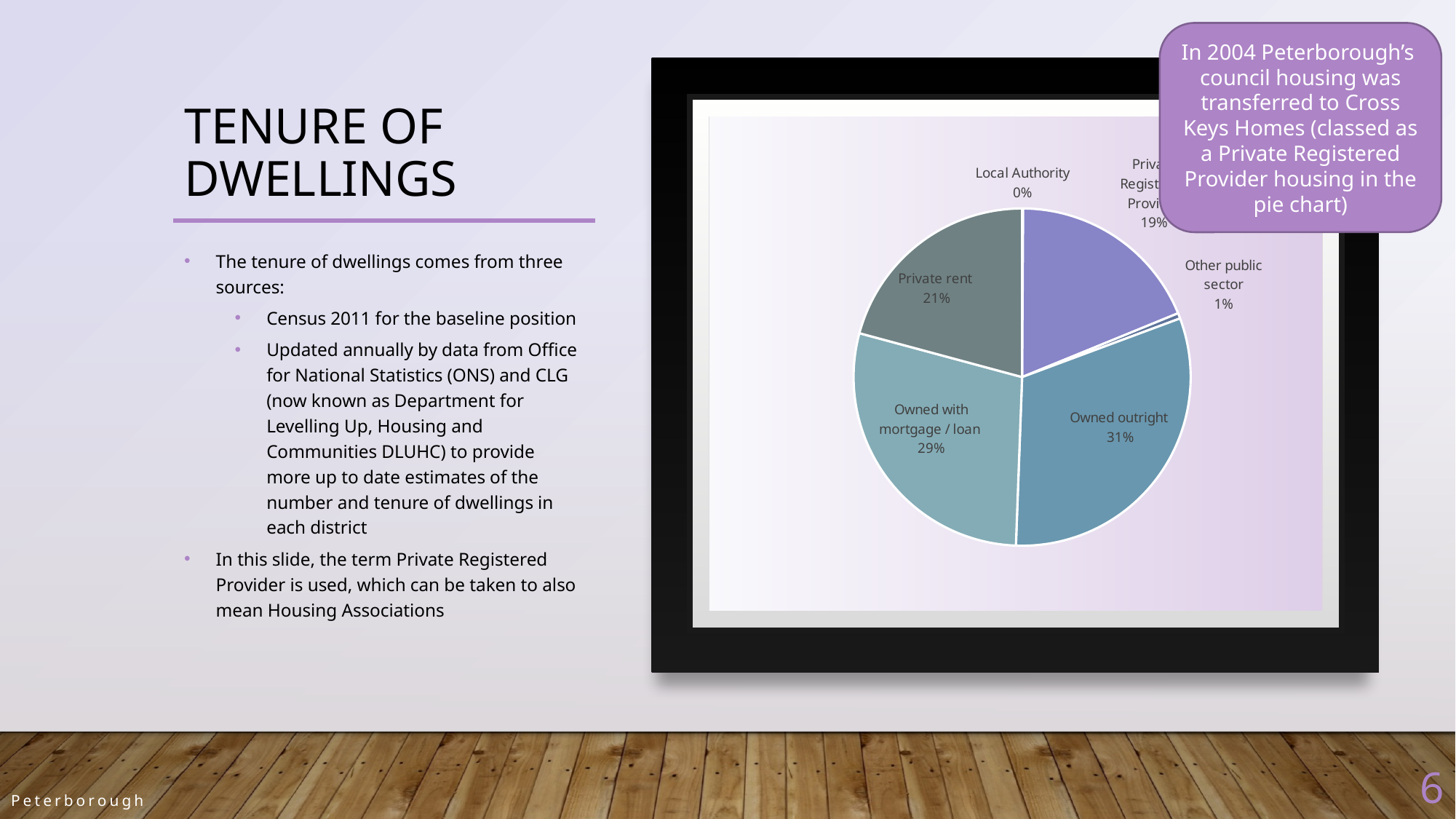
What kind of chart is shown on the slide? pie chart What share of dwellings is Owned outright? 31% What share of dwellings is Owned with mortgage / loan? 29% Which is larger, Private rent or Owned with mortgage / loan? Owned with mortgage / loan Which tenure category has the smallest share of the pie? Local Authority What is the combined share of Owned outright and Owned with mortgage / loan? 60% How many tenure categories are shown in the pie chart? 6 How many percentage points larger is Owned outright than Owned with mortgage / loan? 2 What share of dwellings is Local Authority? 0% Which tenure category has the largest share of the pie? Owned outright What share of dwellings is Private rent? 21% What share of dwellings is Other public sector? 1%